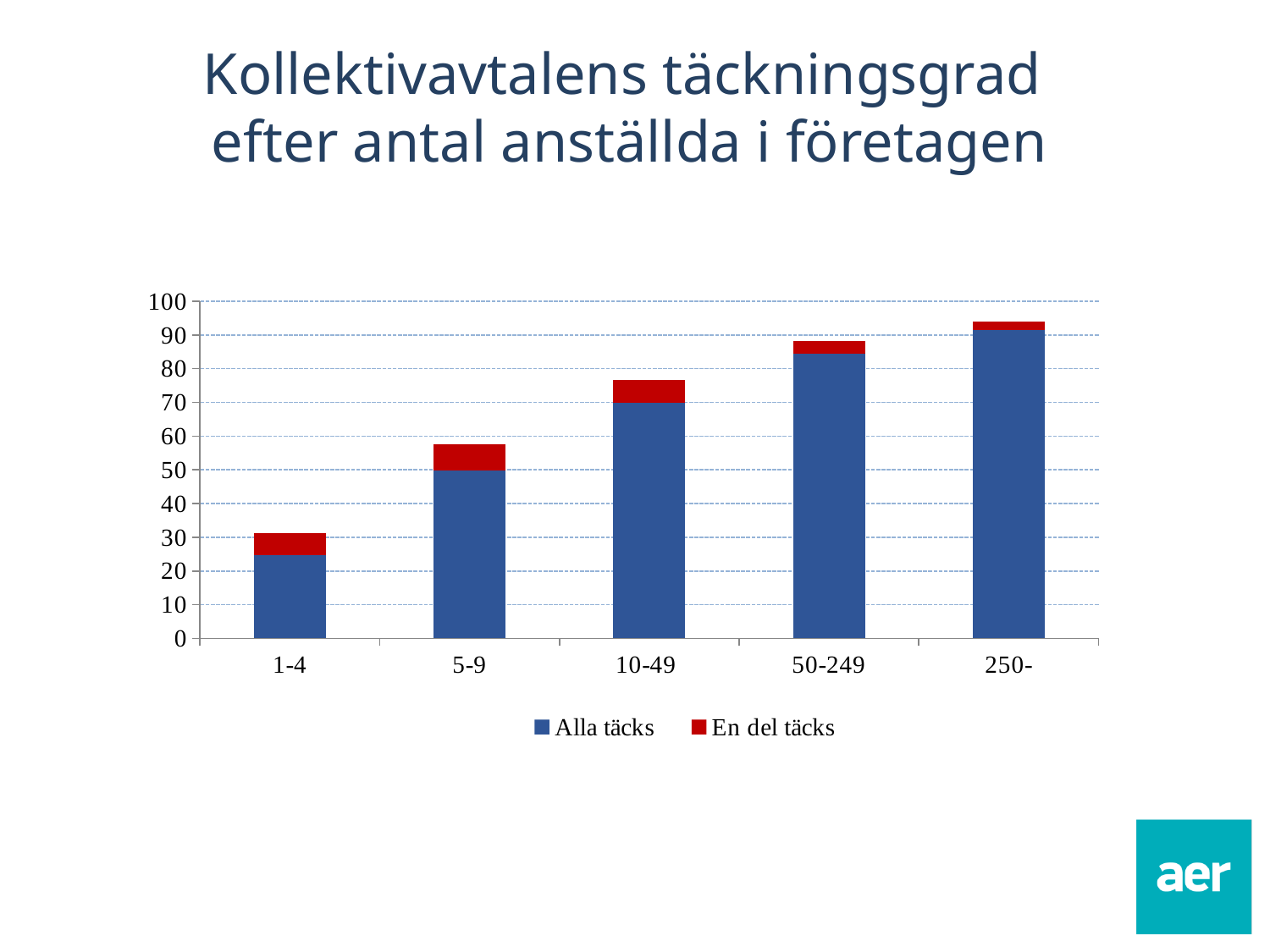
How many company-size categories are shown on the x axis? 5 Which company-size category has the lowest total bar? 1-4 What kind of chart is shown on the slide? Stacked bar chart Do the total bar heights rise or fall as company size increases along the x axis? Rise Is the total stacked bar for the 250- category greater or less than 90? greater Is the 'Alla täcks' value for the 50-249 category greater or less than 80? greater How many series does the legend list? 2 What are the two legend entries of the chart? Alla täcks and En del täcks Which company-size category has the highest total bar? 250- Is the 'Alla täcks' value for the 1-4 category greater or less than 30? less Which has a larger 'Alla täcks' value, the 10-49 category or the 50-249 category? 50-249